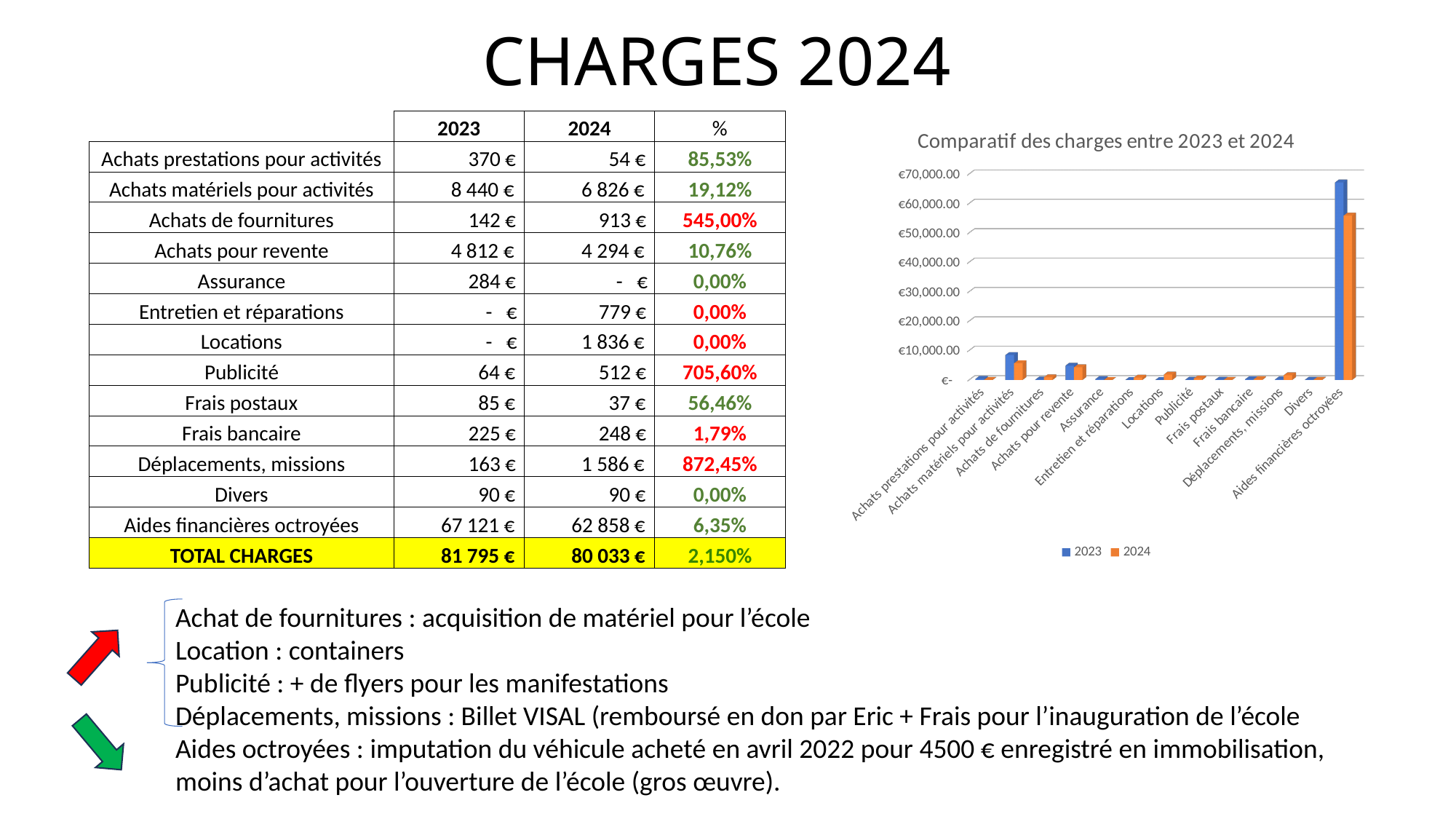
For Achats matériels pour activités, which series has the larger value, 2023 or 2024? 2023 What is the difference between the 2023 and 2024 values for Aides financières octroyées? 4 263 € Is the 2023 value for Achats matériels pour activités greater or less than €10,000.00? less Which colour represents the 2024 series in the chart? orange How many categories are shown on the x axis of the chart? 13 Is the 2024 value for Aides financières octroyées greater or less than €50,000.00? greater What is the 2023 value for Achats matériels pour activités? 8 440 € What kind of chart is shown on the slide? bar chart How many series does the chart legend list? 2 Is the 2023 value for Aides financières octroyées greater or less than €60,000.00? greater What is the title of the chart? Comparatif des charges entre 2023 et 2024 Which category has the highest 2023 bar in the chart? Aides financières octroyées